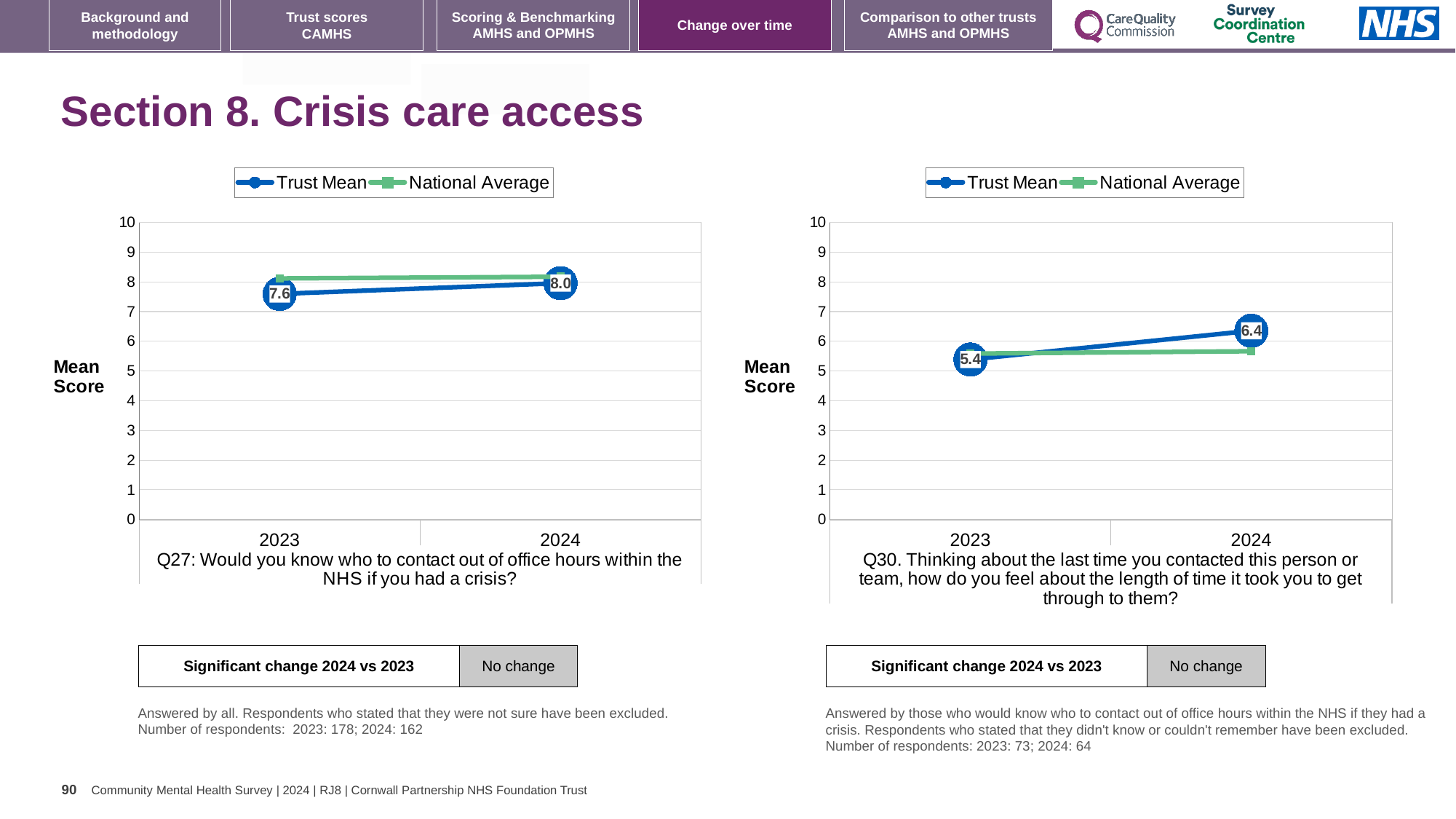
How many series does the legend of the left chart (Q27) list? 2 In the right chart (Q30), what is the Trust Mean score for 2023? 5.4 In the right chart (Q30), which is larger in 2024, the Trust Mean or the National Average? Trust Mean How many years are plotted on the x axis of the right chart (Q30)? 2 In the left chart (Q27), what is the Trust Mean score for 2023? 7.6 In the right chart (Q30), by how much did the Trust Mean change from 2023 to 2024? 1.0 In the left chart (Q27), by how much did the Trust Mean change from 2023 to 2024? 0.4 In the left chart (Q27), does the Trust Mean rise or fall from 2023 to 2024? rise What kind of chart is the right chart (Q30)? line chart In the left chart (Q27), what is the Trust Mean score for 2024? 8.0 In the right chart (Q30), is the National Average for 2023 greater or less than 6? less In the right chart (Q30), what is the Trust Mean score for 2024? 6.4